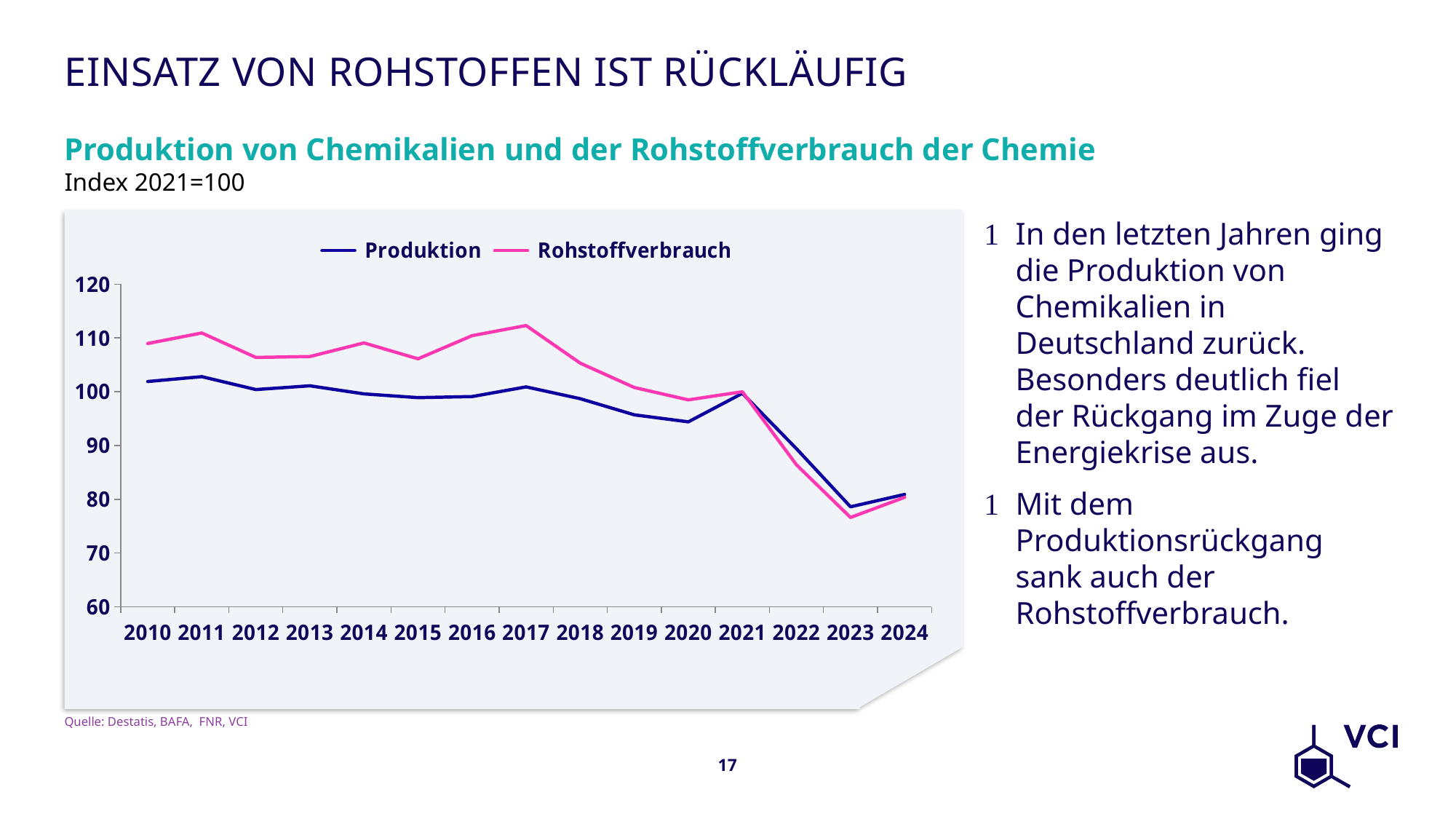
How many years are shown on the x axis of the chart? 15 Is the value for Rohstoffverbrauch in 2023 greater or less than 80? less What kind of chart is shown on the slide? line chart Does the Produktion line rise or fall from 2021 to 2023? fall How many series does the chart's legend list? 2 In which year is the Rohstoffverbrauch line at its lowest? 2023 Is the value for Rohstoffverbrauch in 2010 greater or less than 100? greater In 2017, which series has the higher value, Produktion or Rohstoffverbrauch? Rohstoffverbrauch Is the value for Rohstoffverbrauch in 2017 greater or less than 110? greater What colour is the Rohstoffverbrauch line in the chart? pink